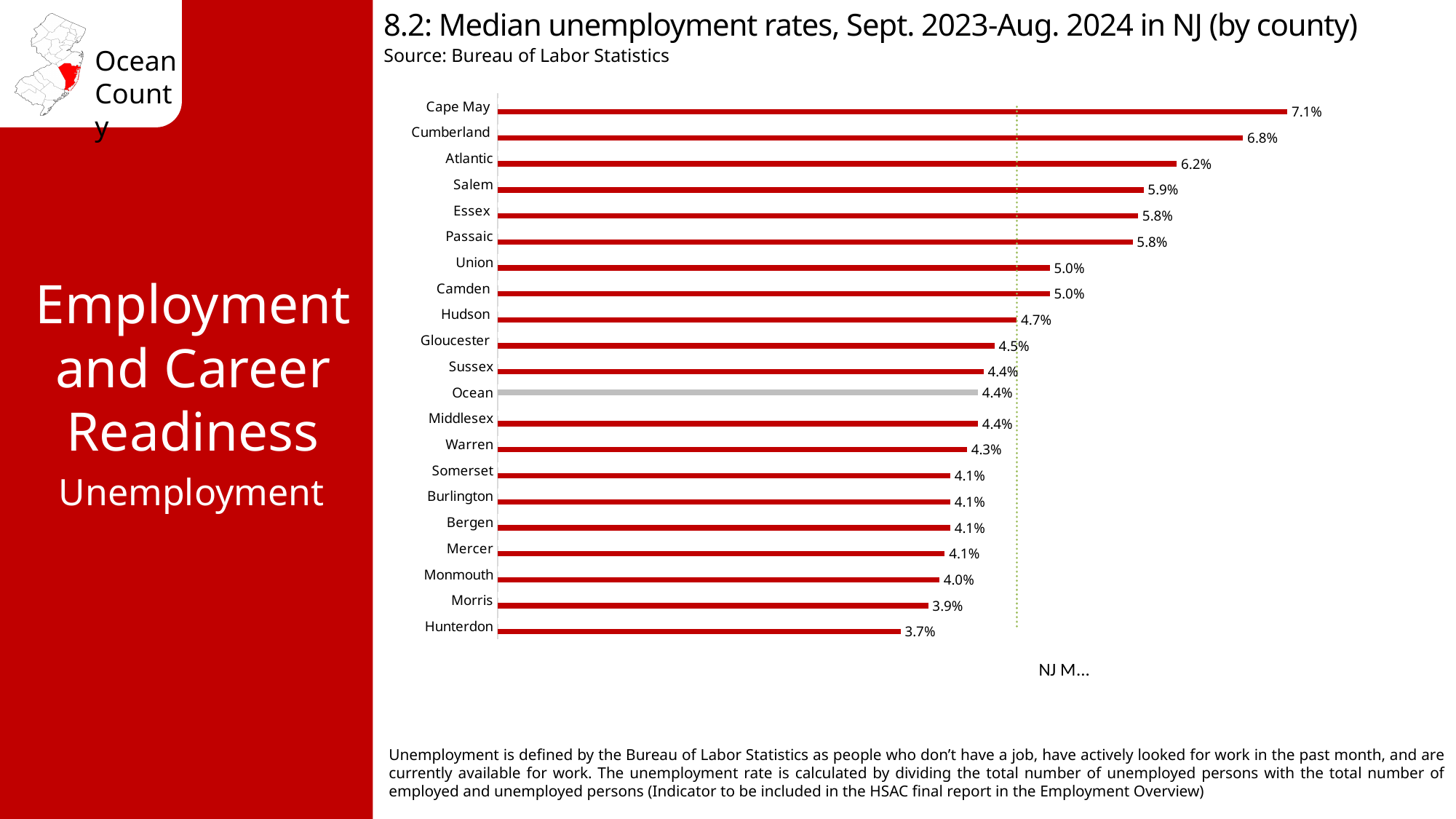
What type of chart is used to show the median unemployment rates by county? Bar chart How many counties are shown on the chart? 21 What is the median unemployment rate shown for Hudson? 4.7% Which county has the highest median unemployment rate on the chart? Cape May What is the median unemployment rate shown for Cape May? 7.1% What is the difference between the median unemployment rates of Cape May and Hunterdon? 3.4% Which county has a higher median unemployment rate, Morris or Monmouth? Monmouth What is the difference between the median unemployment rates of Cumberland and Ocean? 2.4% Which county's bar is shown in gray rather than red? Ocean Which county has the lowest median unemployment rate on the chart? Hunterdon What is the median unemployment rate shown for Ocean County? 4.4% Which county has a higher median unemployment rate, Atlantic or Salem? Atlantic